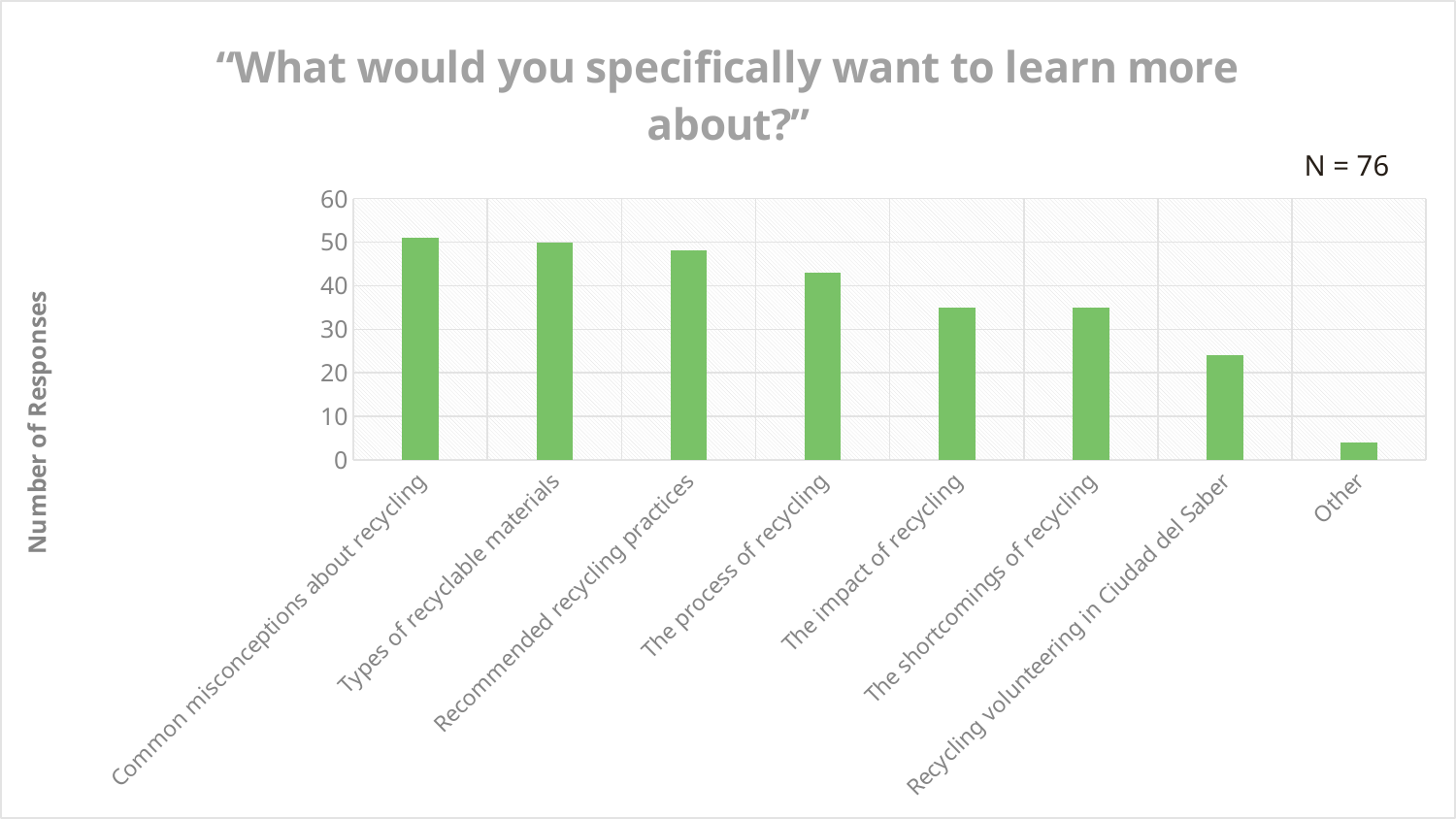
Is the value for "Other" greater or less than 10? less How many categories are shown on the x axis of the chart? 8 Is the value for "Common misconceptions about recycling" greater or less than 40? greater What kind of chart is shown on the slide? Bar chart What sample size (N) is stated on the slide? N = 76 Do the values generally rise or fall moving from left to right along the x axis? Fall What is the label of the y axis? Number of Responses Which has more responses: "The process of recycling" or "The impact of recycling"? The process of recycling Is the value for "The impact of recycling" greater or less than 40? less Which category has the lowest number of responses? Other